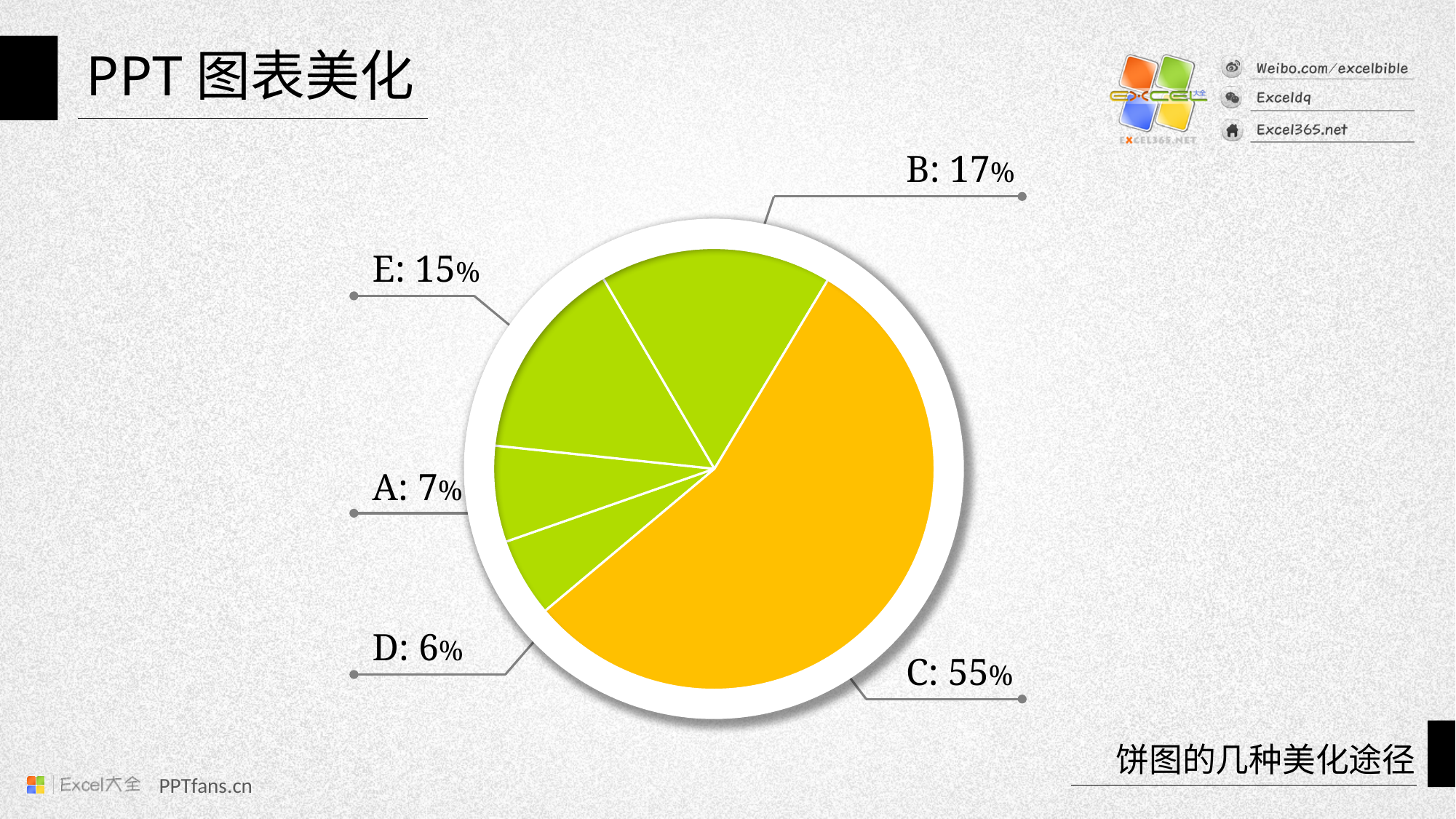
What kind of chart is shown on the slide? pie chart Which slice is the smallest? D Which slice is the largest? C What is the value for slice E? 15% How many slices does the pie chart have? 5 What is the value for slice D? 6% What is the value for slice A? 7% What is the difference between the values for C and B? 38% Which slice of the pie is coloured orange? C What is the value for slice B? 17% Which is larger, the value for B or the value for E? B What is the value for slice C? 55%